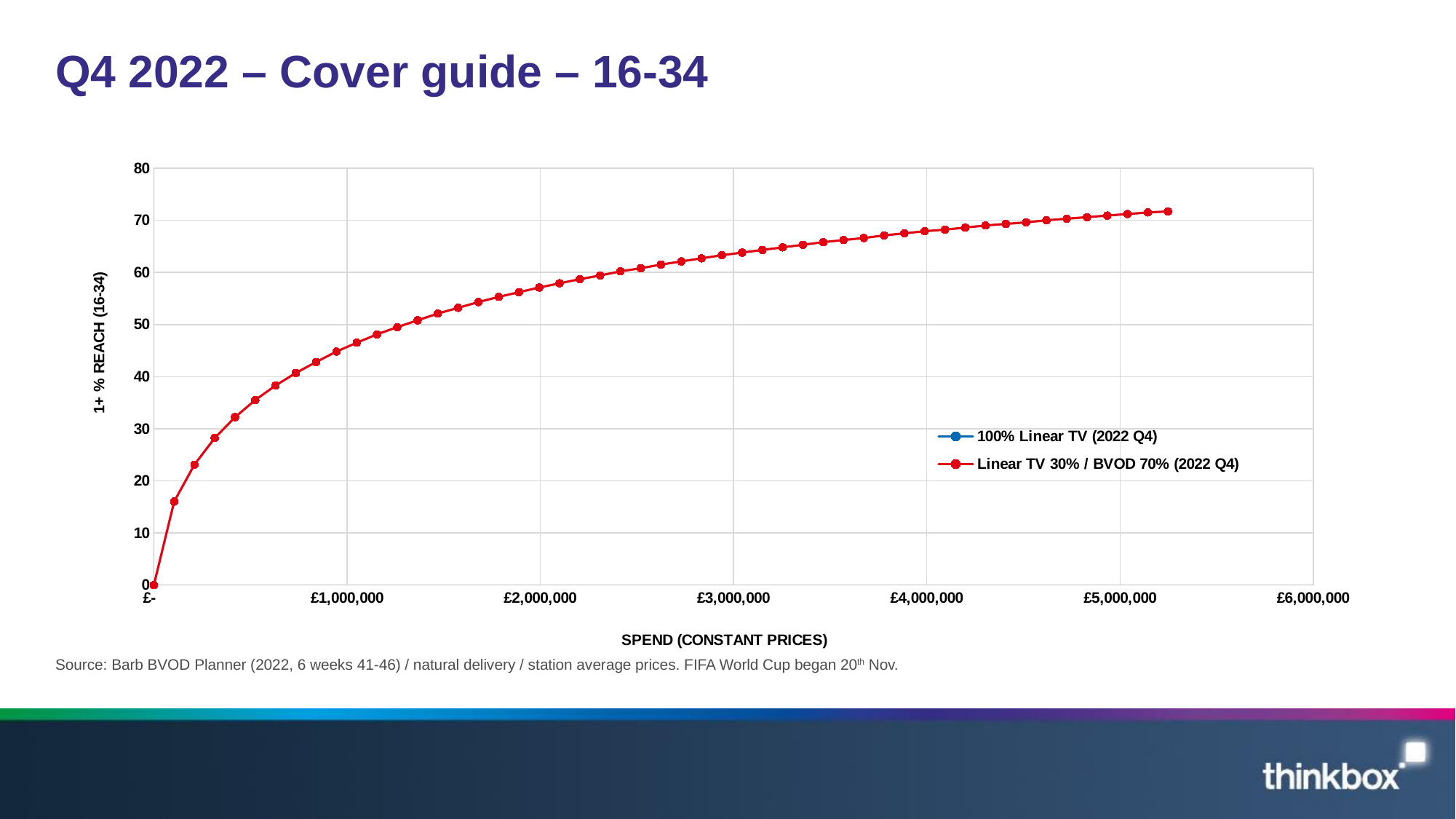
Is the 1+ % reach for the Linear TV 30% / BVOD 70% (2022 Q4) series at £1,000,000 spend greater or less than 40? greater Is the 1+ % reach for the Linear TV 30% / BVOD 70% (2022 Q4) series at £3,000,000 spend greater or less than 60? greater Is the 1+ % reach for the Linear TV 30% / BVOD 70% (2022 Q4) series at £2,000,000 spend greater or less than 50? greater How many series does the legend list? 2 Does the 1+ % reach rise or fall as spend increases along the x axis? Rises What is the 1+ % reach for the Linear TV 30% / BVOD 70% (2022 Q4) series at a spend of £-? 0 Which series is drawn in red in the legend? Linear TV 30% / BVOD 70% (2022 Q4) What is the title of the chart's x axis? SPEND (CONSTANT PRICES) What kind of chart is shown on the slide? Line chart